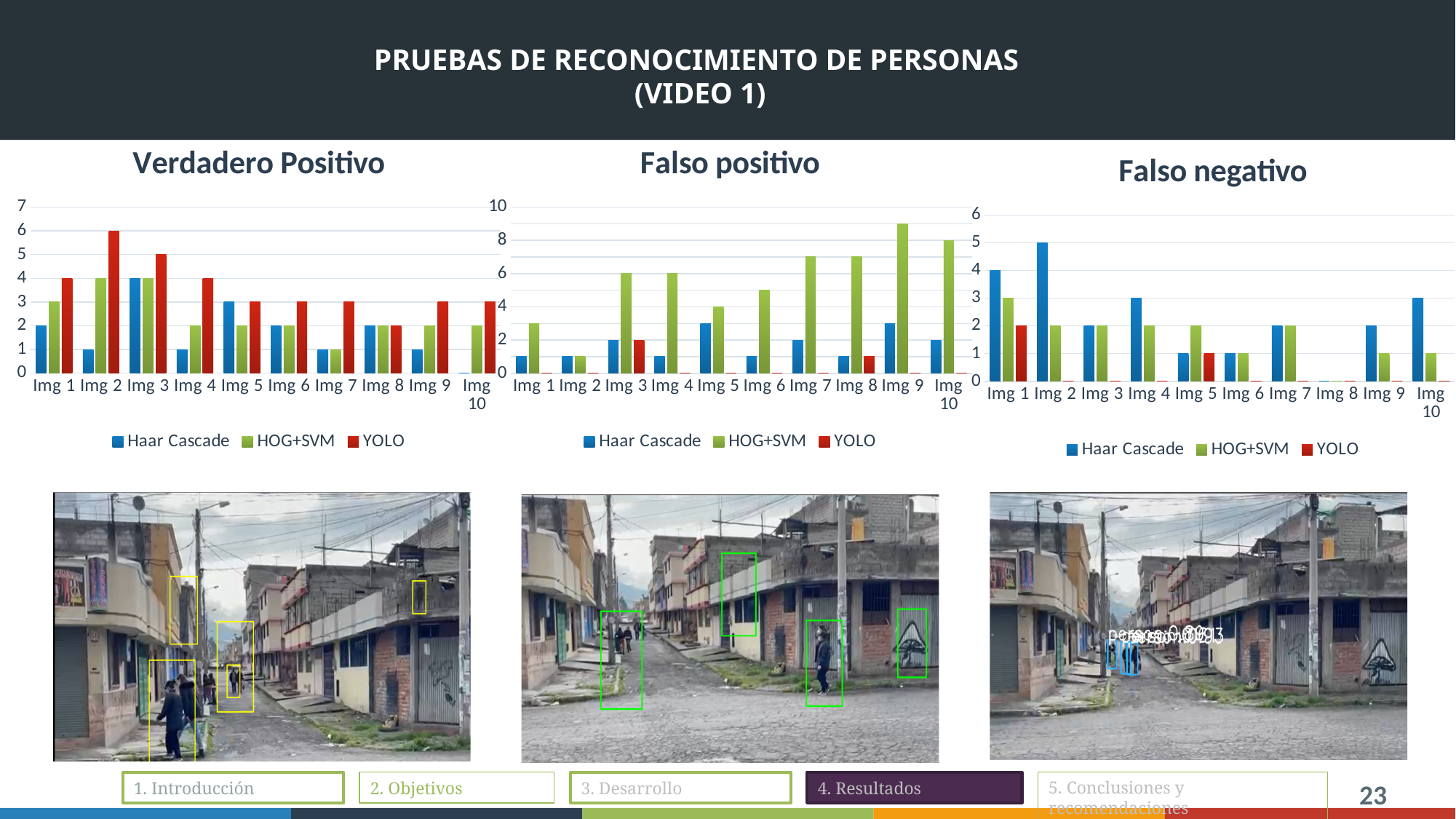
In the Verdadero Positivo chart, what is the YOLO value for Img 2? 6 In the Falso negativo chart, which is larger for Img 1: the Haar Cascade value or the YOLO value? Haar Cascade How many series does the legend of the Falso negativo chart list? 3 In the Verdadero Positivo chart, what is the difference between the YOLO and Haar Cascade values for Img 2? 5 In the Falso positivo chart, what is the HOG+SVM value for Img 10? 8 What type of chart is the Verdadero Positivo chart? Bar chart In the Verdadero Positivo chart, which image has the highest YOLO value? Img 2 In the Verdadero Positivo chart, what is the Haar Cascade value for Img 3? 4 In the Falso positivo chart, which image has the highest HOG+SVM value? Img 9 In the Falso negativo chart, which image has the highest Haar Cascade value? Img 2 In the Falso negativo chart, what is the Haar Cascade value for Img 2? 5 In the Falso positivo chart, is the HOG+SVM value for Img 9 greater or less than 8? greater